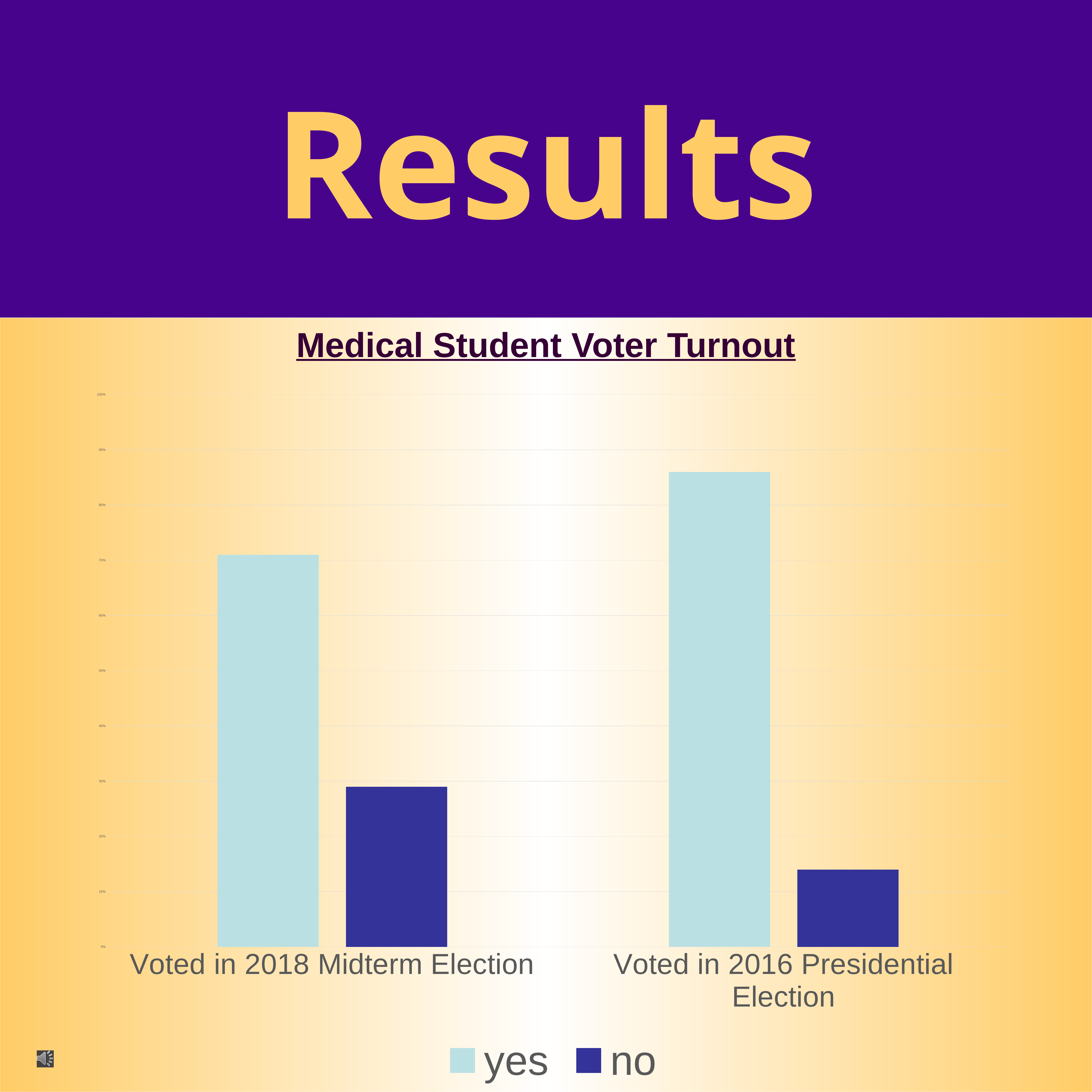
Is the 'yes' value for Voted in 2018 Midterm Election greater or less than 60%? greater How many categories are shown on the x axis? 2 Which category has the larger 'no' value, Voted in 2018 Midterm Election or Voted in 2016 Presidential Election? Voted in 2018 Midterm Election Is the 'no' value for Voted in 2016 Presidential Election greater or less than 20%? less Which category has the larger 'yes' value, Voted in 2018 Midterm Election or Voted in 2016 Presidential Election? Voted in 2016 Presidential Election Which bar is the shortest in the chart? no for Voted in 2016 Presidential Election What is the title of the chart? Medical Student Voter Turnout How many series does the legend list? 2 What kind of chart is shown on the slide? bar chart Which bar is the tallest in the chart? yes for Voted in 2016 Presidential Election Is the 'yes' value for Voted in 2016 Presidential Election greater or less than 80%? greater Which legend entry is shown in dark blue? no